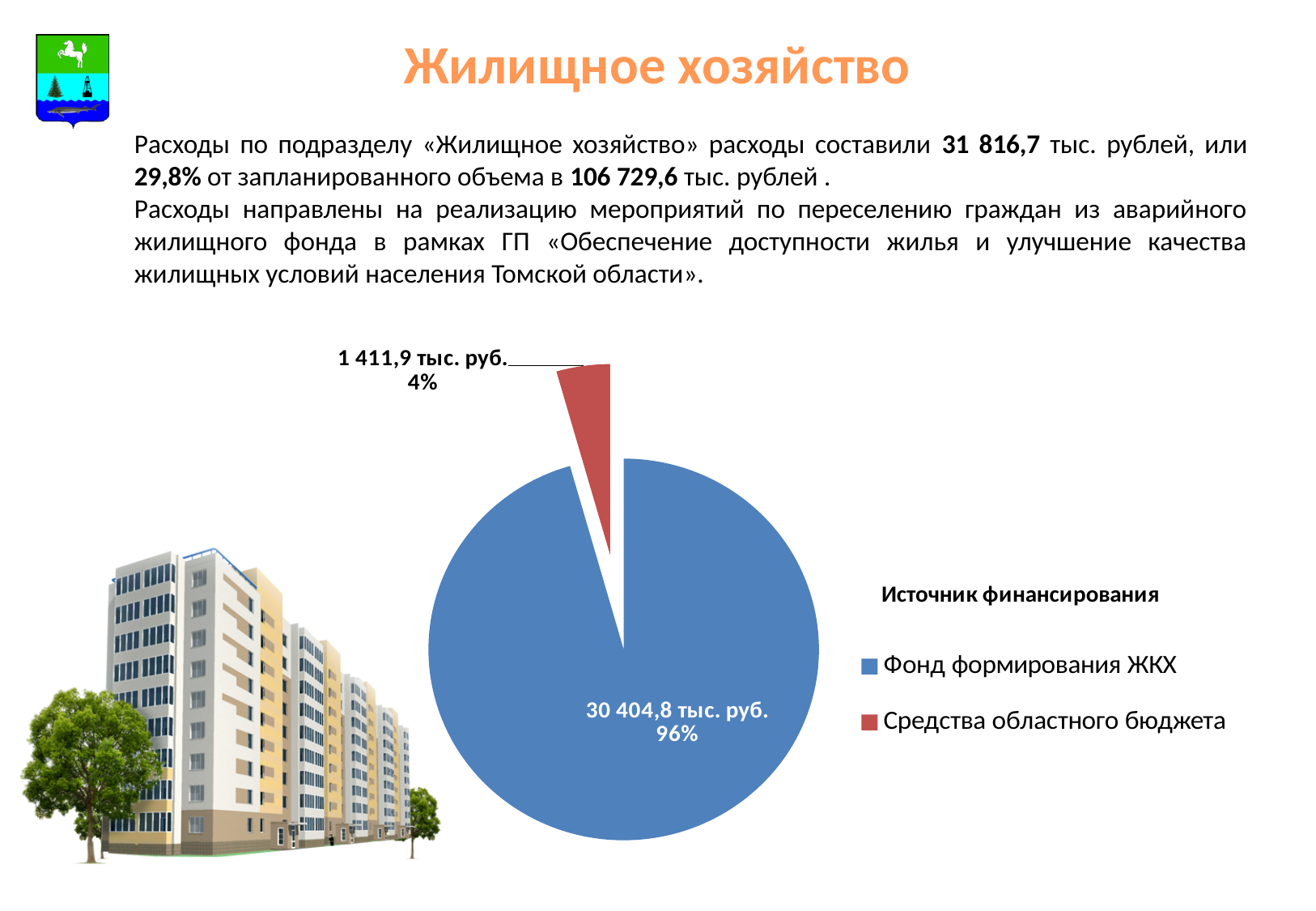
Which source of funding has the largest slice in the pie chart? Фонд формирования ЖКХ What is the value for Фонд формирования ЖКХ in the pie chart? 30 404,8 тыс. руб. How many entries does the legend of the pie chart list? 2 What colour is the slice for Средства областного бюджета in the pie chart? red Which source of funding has the smallest slice in the pie chart? Средства областного бюджета How many slices does the pie chart have? 2 Which is larger: Фонд формирования ЖКХ or Средства областного бюджета? Фонд формирования ЖКХ What is the value for Средства областного бюджета in the pie chart? 1 411,9 тыс. руб. What kind of chart is shown on the slide? pie chart What share of the pie does Фонд формирования ЖКХ represent? 96% What share of the pie does Средства областного бюджета represent? 4% What is the title shown above the legend of the pie chart? Источник финансирования